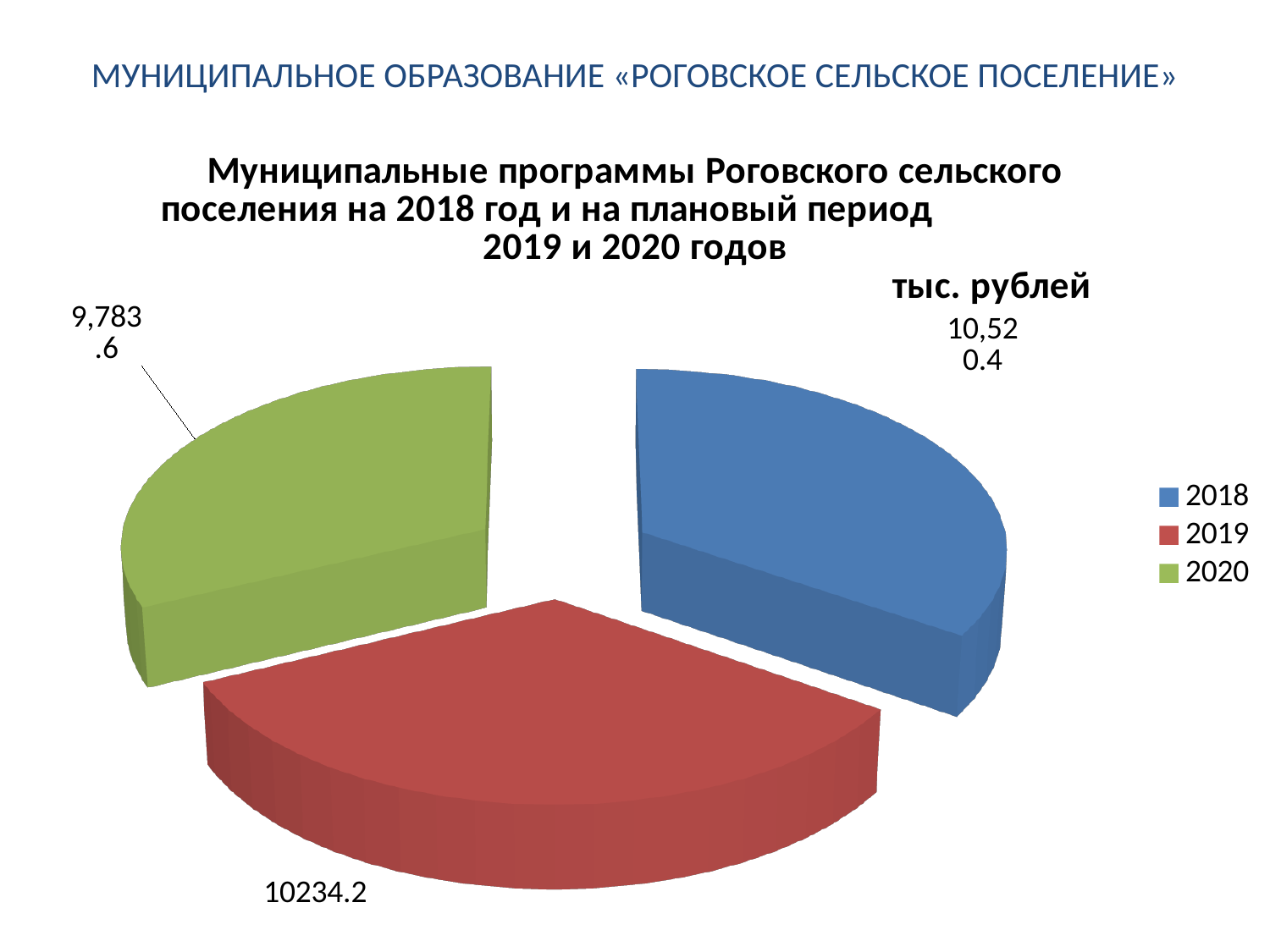
In what units are the values on the chart given? тыс. рублей Which is larger, the value for 2019 or the value for 2020? 2019 Which year has the smallest value on the pie chart? 2020 What is the value for 2019 on the pie chart? 10234.2 What is the value for 2018 on the pie chart? 10,520.4 How many entries does the legend list? 3 How many slices does the pie chart have? 3 What is the value for 2020 on the pie chart? 9,783.6 What kind of chart is shown on the slide? Pie chart Which year has the largest value on the pie chart? 2018 What is the difference between the values for 2018 and 2019? 286.2 What is the difference between the values for 2019 and 2020? 450.6